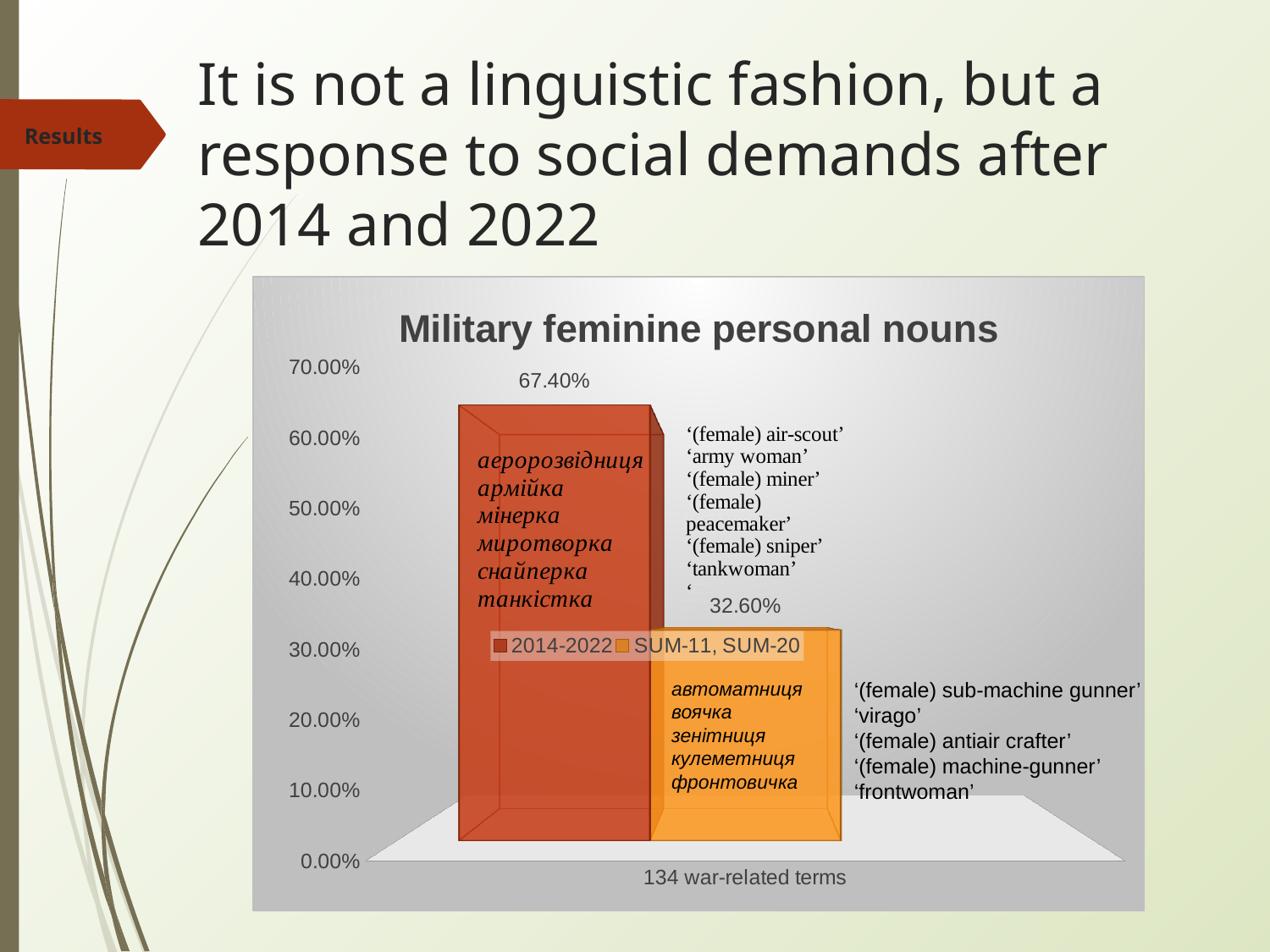
Is the value for SUM-11, SUM-20 greater or less than 40.00%? less What type of chart is shown on the slide? bar chart What is the value for the 2014-2022 series? 67.40% Which series has the lowest value? SUM-11, SUM-20 Is the value for 2014-2022 greater or less than 60.00%? greater Which series has the higher value, 2014-2022 or SUM-11, SUM-20? 2014-2022 What is the value for the SUM-11, SUM-20 series? 32.60% What is the title of the chart? Military feminine personal nouns How many series does the legend list? 2 What is the difference between the 2014-2022 value and the SUM-11, SUM-20 value? 34.80% What is the category label shown on the x axis? 134 war-related terms What is the total of the two series values shown in the chart? 100.00%